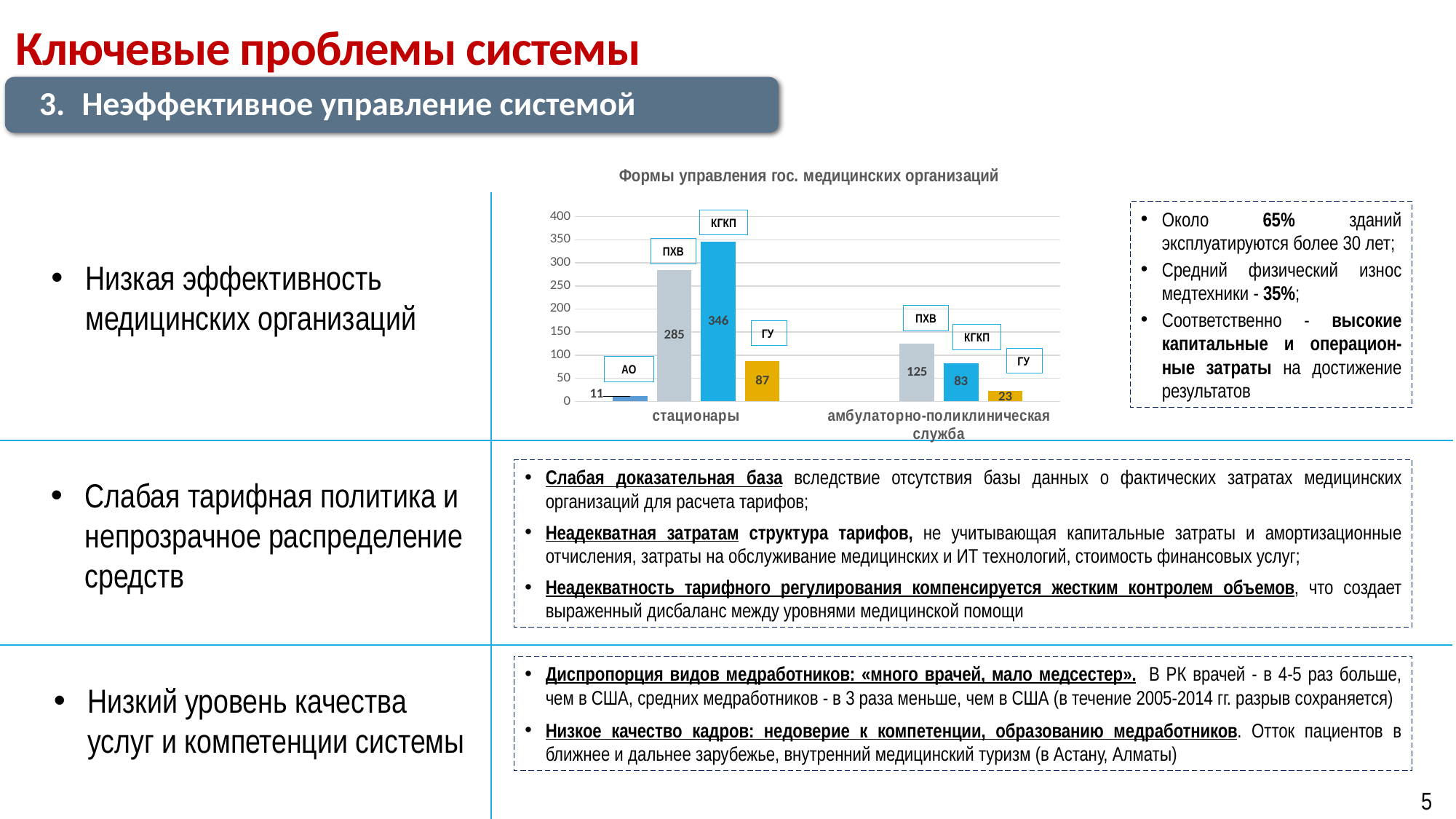
Which form of management has the highest value in the амбулаторно-поликлиническая служба group? ПХВ Which form of management has the highest value in the стационары group? КГКП What is the value for ГУ in the амбулаторно-поликлиническая служба group? 23 What is the value for КГКП in the стационары group? 346 Which is larger: the ПХВ value for амбулаторно-поликлиническая служба or the ГУ value for стационары? ПХВ value for амбулаторно-поликлиническая служба What is the value for ПХВ in the стационары group? 285 What type of chart is shown on the slide? bar chart What is the title of the chart on the slide? Формы управления гос. медицинских организаций What is the value for АО in the стационары group? 11 How many category groups are shown on the x axis of the chart? 2 What is the difference between the КГКП value and the ПХВ value in the стационары group? 61 Is the value for КГКП in the амбулаторно-поликлиническая служба group greater or less than 100? less